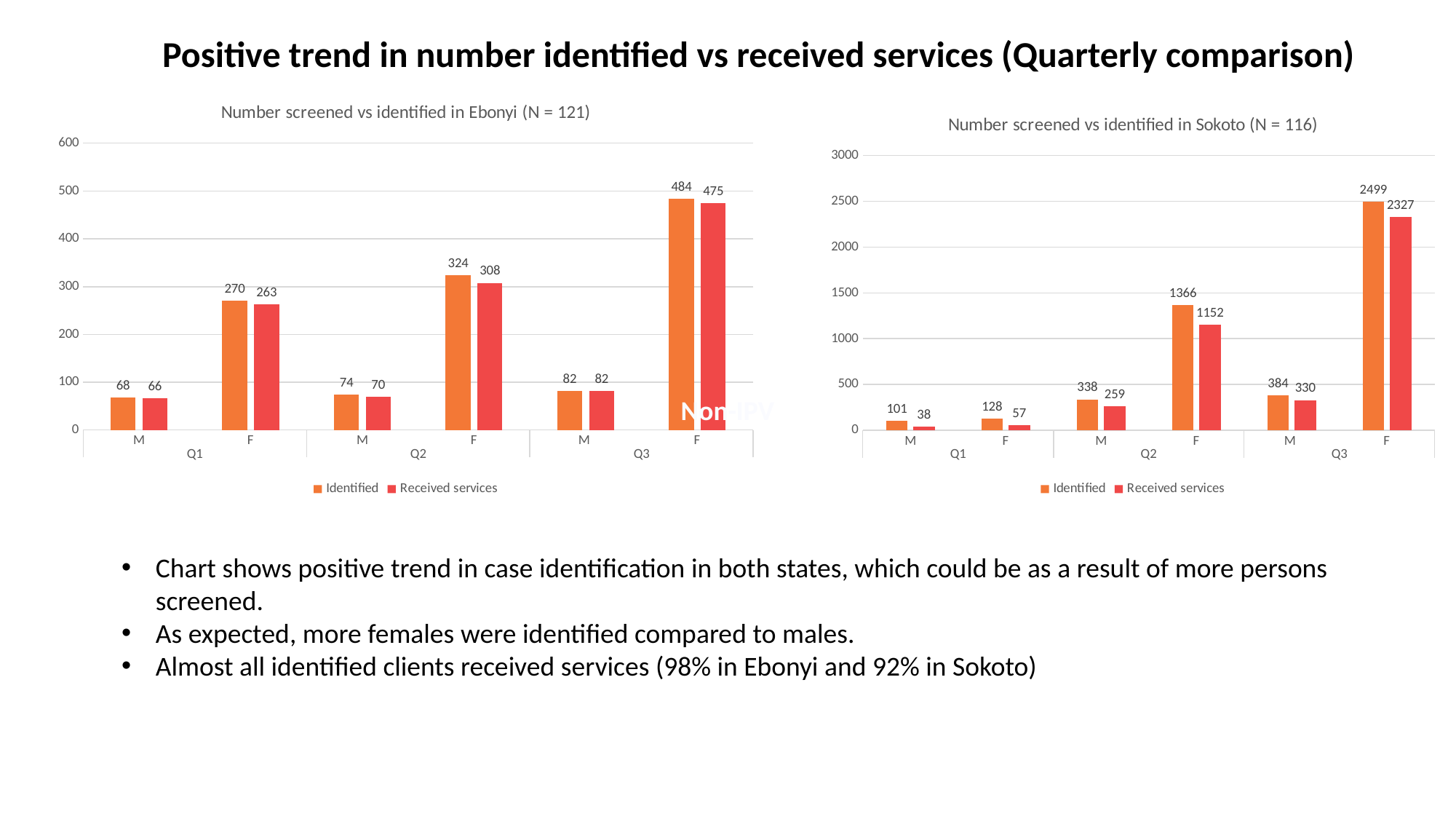
In the Sokoto chart, do the Identified values for F rise or fall from Q1 to Q3? Rise In the Ebonyi chart, how many series does the legend list? 2 What is the title of the left chart? Number screened vs identified in Ebonyi (N = 121) In the Ebonyi chart, what is the Identified value for F in Q3? 484 In the Ebonyi chart, which category has the lowest Received services value? M in Q1 What kind of chart is the Sokoto chart? Bar chart In the Sokoto chart, what is the Received services value for M in Q1? 38 In the Sokoto chart, what is the difference between Identified and Received services for F in Q3? 172 In the Sokoto chart, which category has the highest Identified value? F in Q3 In the Ebonyi chart, what is the Received services value for M in Q2? 70 In the Ebonyi chart, what is the difference between Identified and Received services for F in Q2? 16 In the Sokoto chart, which is larger: the Identified value for F in Q2 or the Received services value for F in Q2? Identified